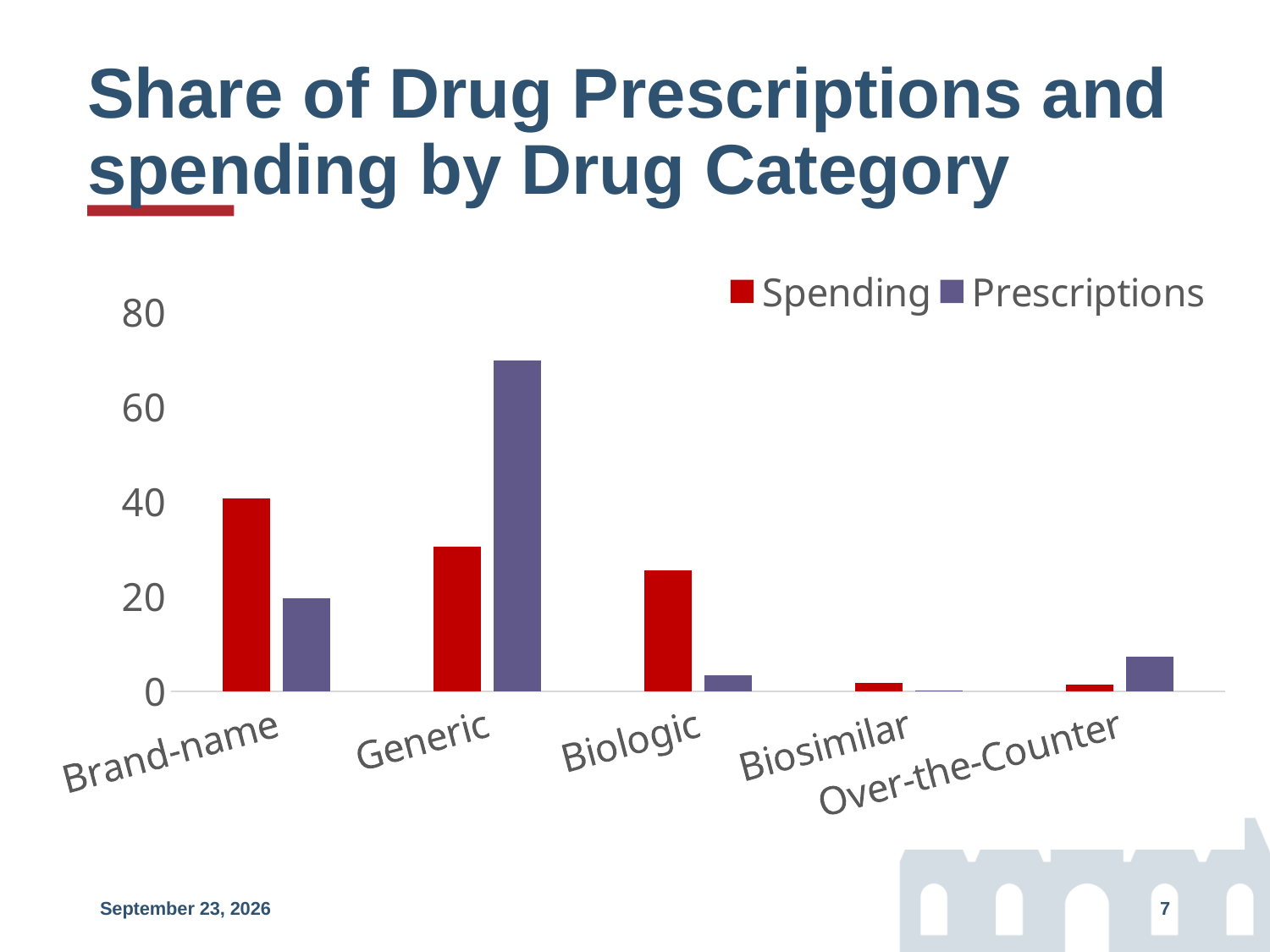
Which category has the highest Prescriptions value? Generic For Generic, which is larger: Spending or Prescriptions? Prescriptions Which colour represents the Spending series in the legend? red Which category has the lowest Prescriptions value? Biosimilar Is the Spending value for Biologic greater or less than 20? greater Which category has the highest Spending value? Brand-name How many series does the legend list? 2 What kind of chart is shown on the slide? bar chart Is the Prescriptions value for Generic greater or less than 60? greater How many drug categories are shown on the x axis? 5 Is the Prescriptions value for Over-the-Counter greater or less than 20? less